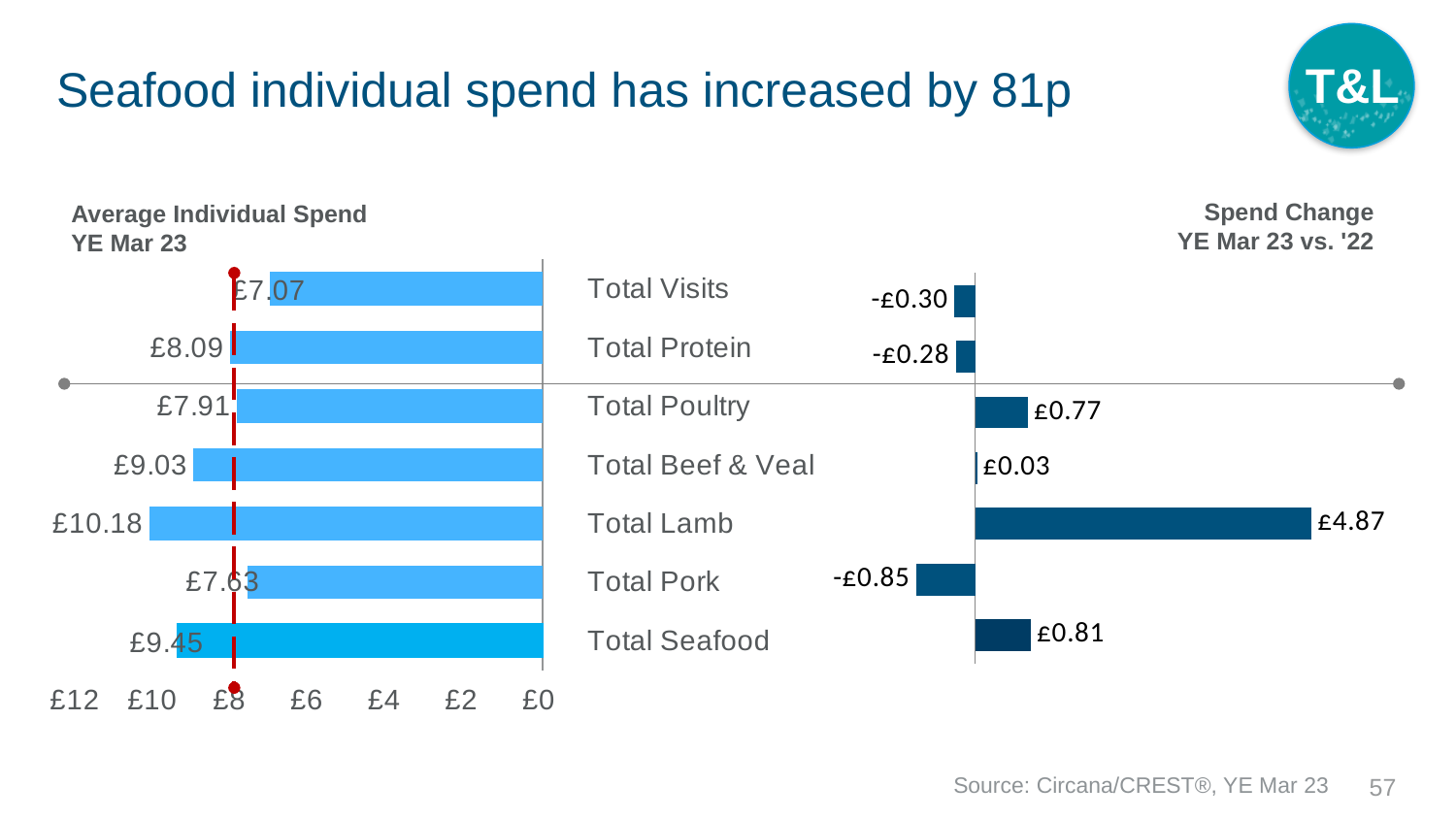
In the Average Individual Spend YE Mar 23 chart, what is the value for Total Lamb? £10.18 In the Average Individual Spend YE Mar 23 chart, what is the value for Total Seafood? £9.45 What kind of chart is the Average Individual Spend YE Mar 23 chart? Bar chart In the Average Individual Spend YE Mar 23 chart, which category has the lowest spend? Total Visits In the Average Individual Spend YE Mar 23 chart, which category has the highest spend? Total Lamb In the Average Individual Spend YE Mar 23 chart, how many categories are shown? 7 In the Spend Change YE Mar 23 vs. '22 chart, which is larger, the change for Total Poultry or Total Seafood? Total Seafood In the Average Individual Spend YE Mar 23 chart, what is the difference between Total Lamb and Total Pork? £2.55 In the Spend Change YE Mar 23 vs. '22 chart, what is the value for Total Beef & Veal? £0.03 In the Spend Change YE Mar 23 vs. '22 chart, which category has the lowest spend change? Total Pork In the Spend Change YE Mar 23 vs. '22 chart, which category has the largest spend change? Total Lamb In the Spend Change YE Mar 23 vs. '22 chart, what is the value for Total Pork? -£0.85